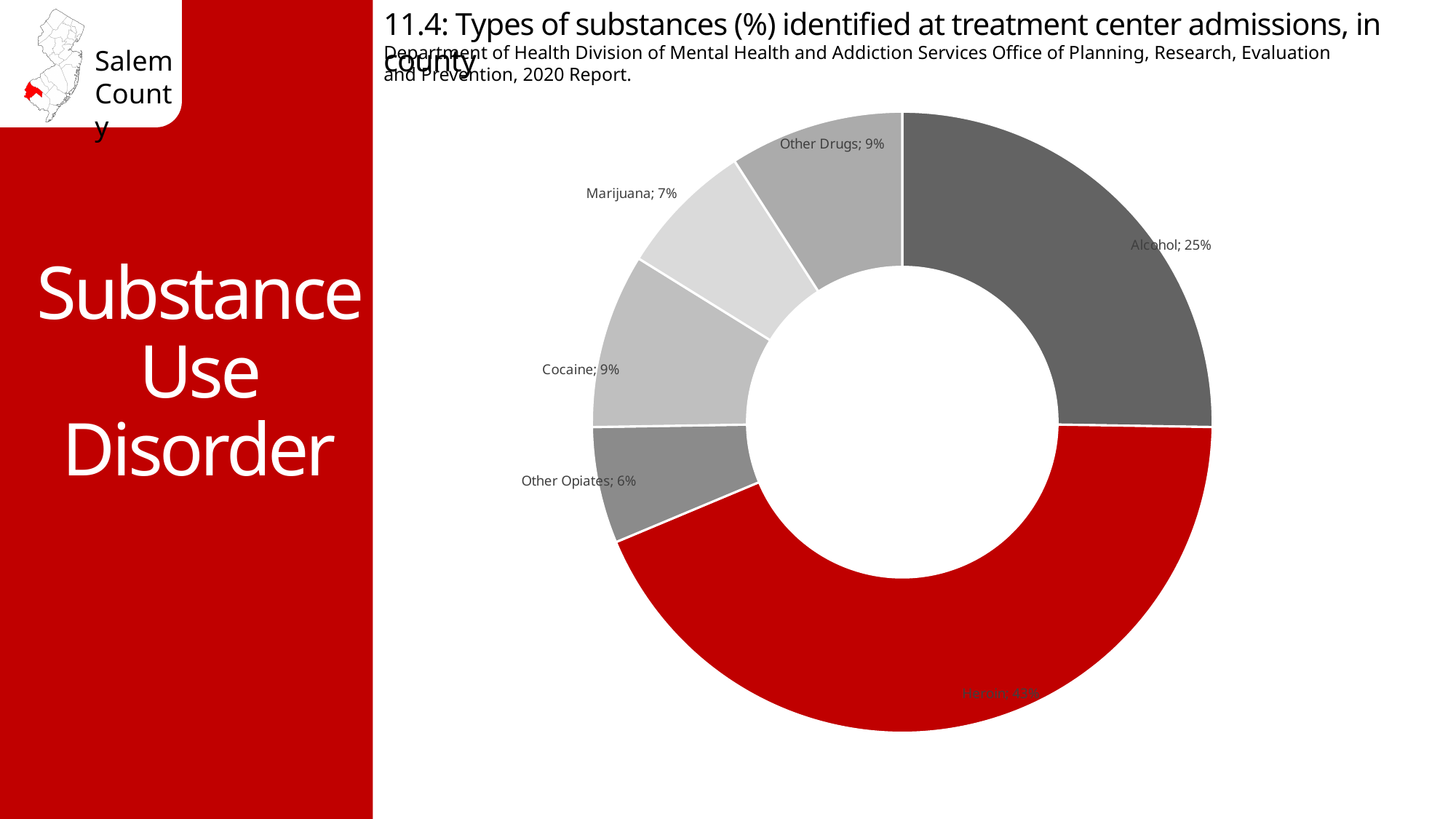
What percentage is shown for Cocaine? 9% What percentage is shown for Other Drugs? 9% What percentage is shown for Marijuana? 7% Which substance accounts for the smallest share of admissions? Other Opiates How many substance categories are shown in the chart? 6 What type of chart is used on this slide? Doughnut (pie) chart What percentage is shown for Heroin? 43% Which substance accounts for the largest share of admissions? Heroin Which has a larger share, Cocaine or Marijuana? Cocaine How many percentage points higher is Alcohol than Marijuana? 18 What percentage is shown for Other Opiates? 6% What percentage of treatment center admissions is attributed to Alcohol? 25%